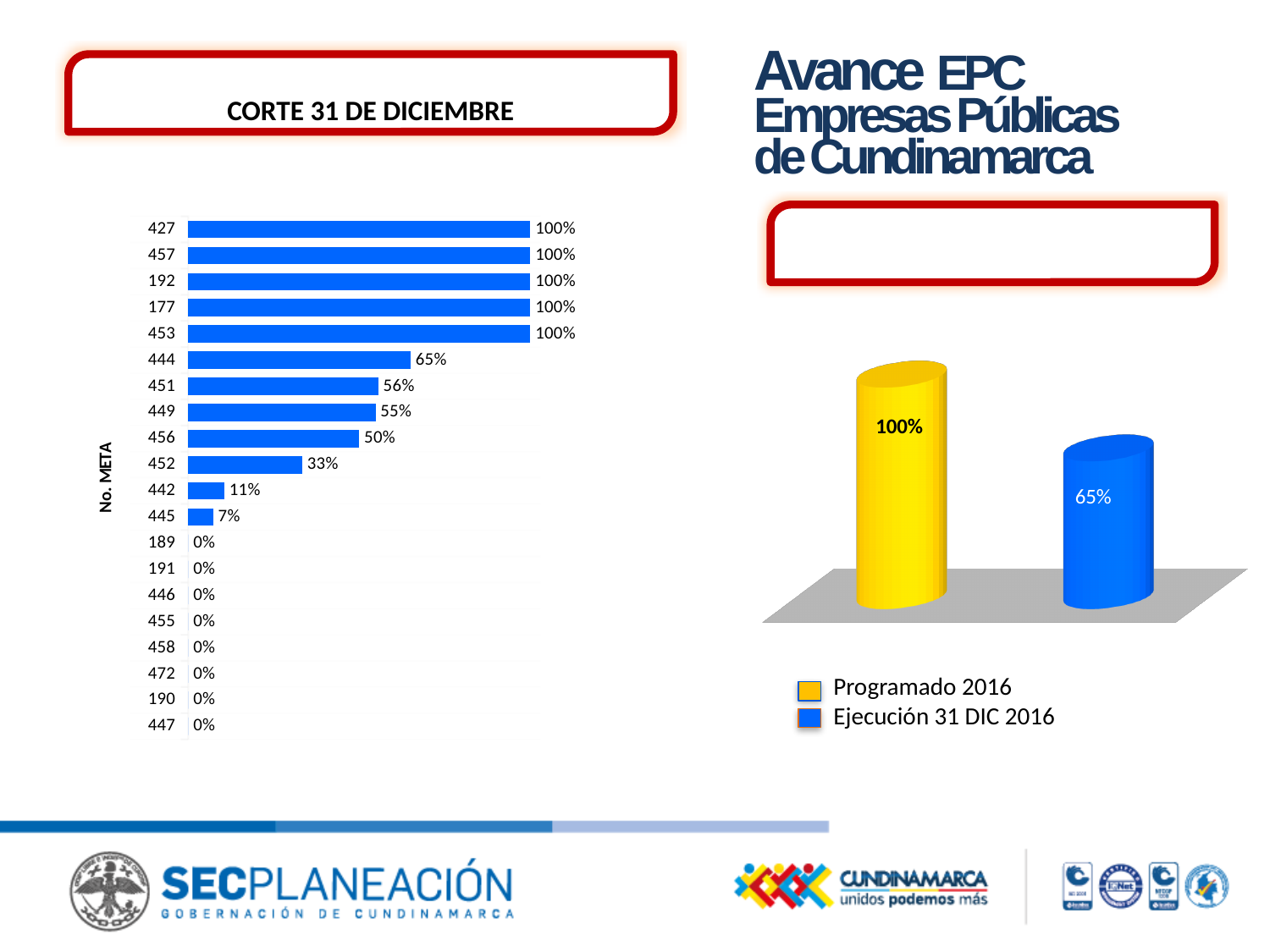
In the left bar chart, what is the value for META 445? 7% In the left bar chart, what is the difference between the values for META 444 and META 442? 54% In the left bar chart, which is larger, the value for META 451 or META 456? 451 In the left bar chart, what is the value for META 452? 33% In the right chart, what is the value for Programado 2016? 100% In the right chart, what is the difference between Programado 2016 and Ejecución 31 DIC 2016? 35% In the left bar chart, what is the value for META 444? 65% In the left bar chart, how many META categories are plotted? 20 In the right chart, what is the value for Ejecución 31 DIC 2016? 65% In the left bar chart, what is the value for META 449? 55% What kind of chart is the chart on the left of the slide? Bar chart How many entries does the legend of the right chart list? 2